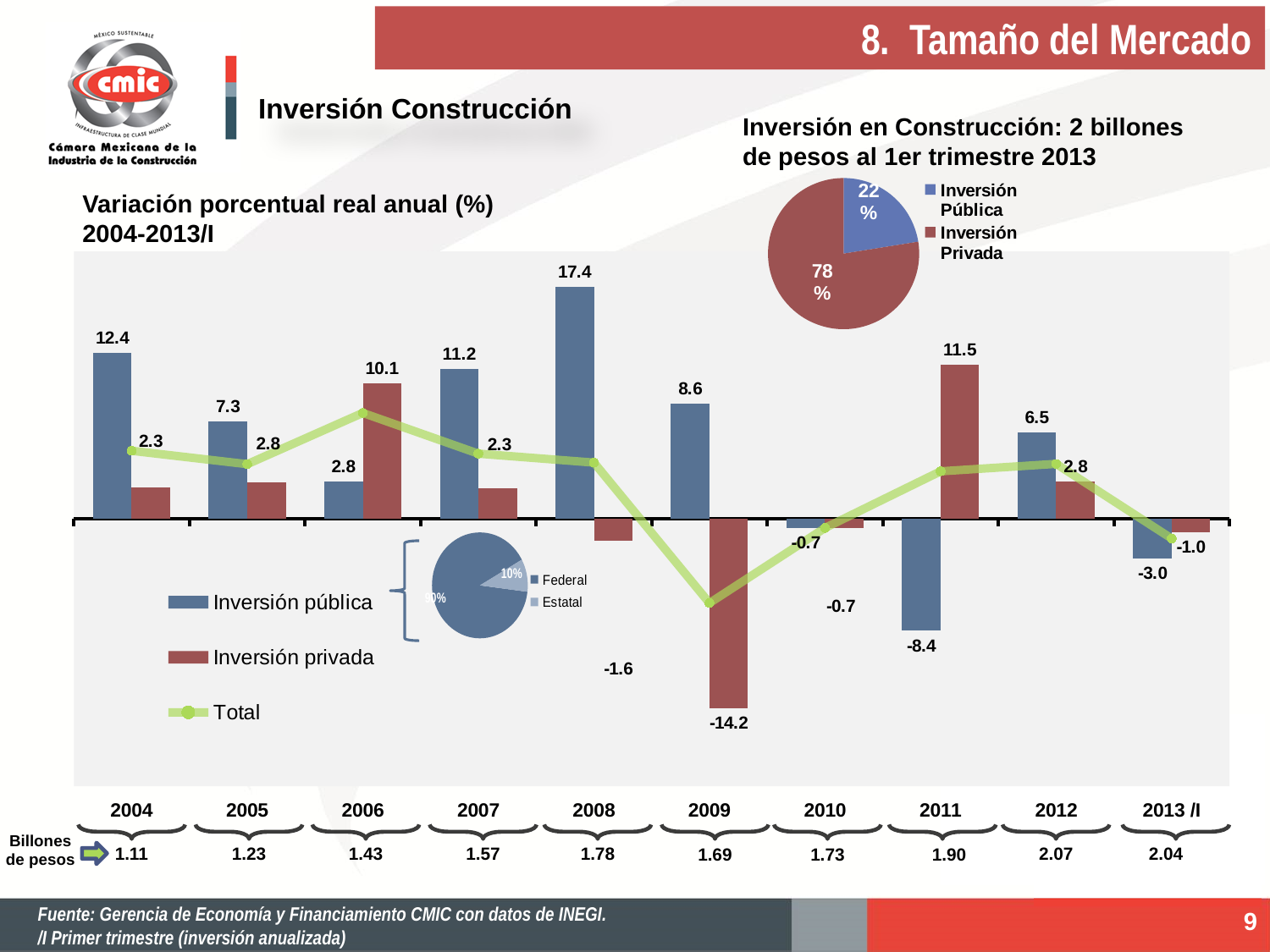
In the 'Variación porcentual real anual (%) 2004-2013/I' chart, which is larger in 2006: Inversión pública or Inversión privada? Inversión privada In the pie chart 'Inversión en Construcción: 2 billones de pesos al 1er trimestre 2013', what share is Inversión Pública? 22% In the 'Variación porcentual real anual (%) 2004-2013/I' chart, what is the value of Inversión pública for 2008? 17.4 In the 'Variación porcentual real anual (%) 2004-2013/I' chart, in which year is Inversión privada lowest? 2009 In the 'Variación porcentual real anual (%) 2004-2013/I' chart, in which year is Inversión pública highest? 2008 In the 'Variación porcentual real anual (%) 2004-2013/I' chart, what is the value of Inversión pública for 2011? -8.4 In the pie chart 'Inversión en Construcción: 2 billones de pesos al 1er trimestre 2013', what share is Inversión Privada? 78% In the 'Variación porcentual real anual (%) 2004-2013/I' chart, what is the value of Inversión privada for 2009? -14.2 In the 'Variación porcentual real anual (%) 2004-2013/I' chart, what is the difference between Inversión privada and Inversión pública in 2011? 19.9 How many series does the legend of the 'Variación porcentual real anual (%) 2004-2013/I' chart list? 3 What kind of chart is the 'Variación porcentual real anual (%) 2004-2013/I' chart? combination bar and line chart How many years (categories) are shown on the x axis of the 'Variación porcentual real anual (%) 2004-2013/I' chart? 10